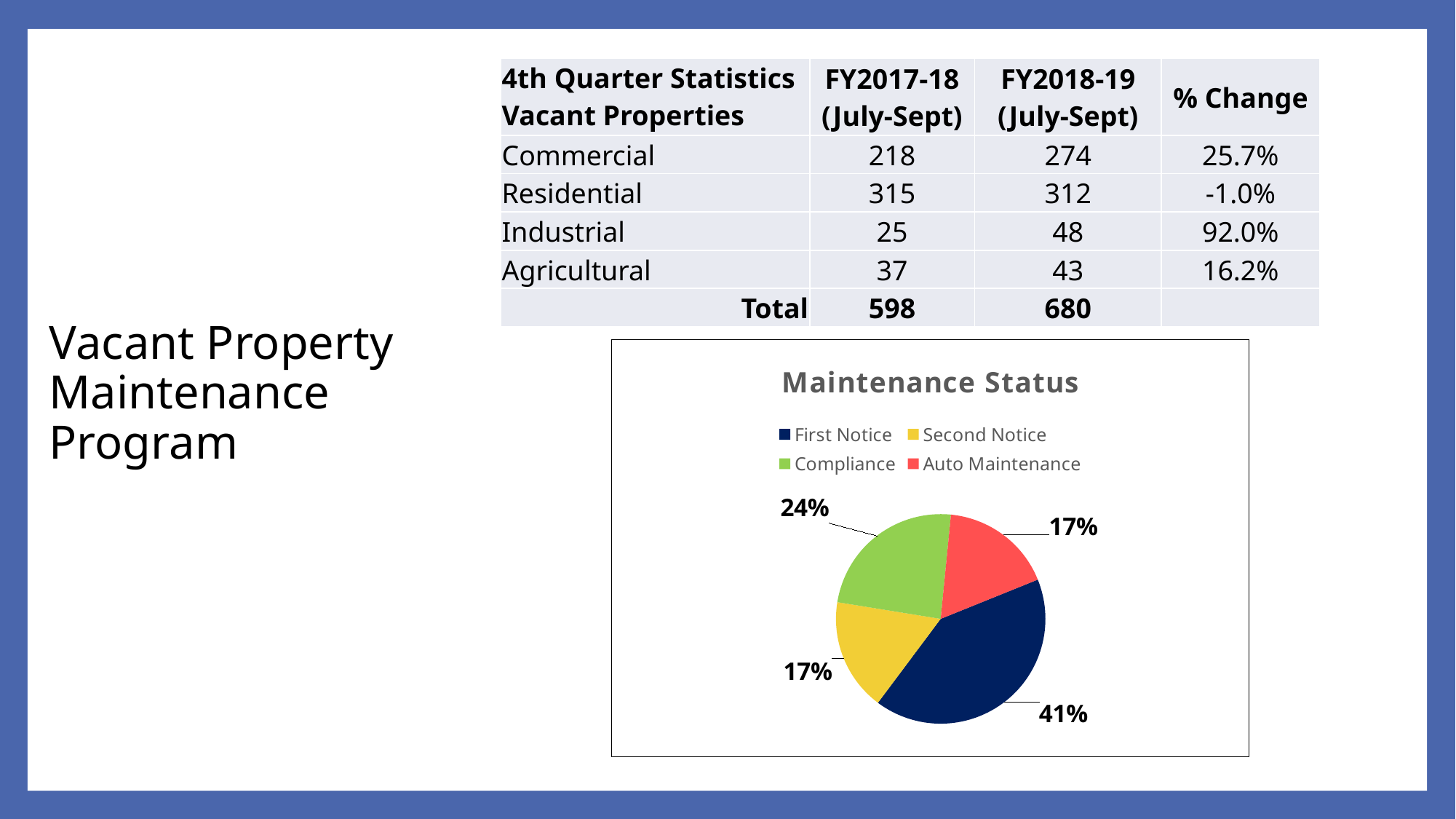
What is the title of the pie chart on the slide? Maintenance Status How many entries does the legend of the Maintenance Status chart list? 4 In the Maintenance Status pie chart, what share is Auto Maintenance? 17% What kind of chart is the Maintenance Status chart? pie chart In the Maintenance Status pie chart, how many percentage points larger is First Notice than Compliance? 17 percentage points In the Maintenance Status pie chart, what share is First Notice? 41% How many slices does the Maintenance Status pie chart have? 4 In the Maintenance Status pie chart, which is larger, Compliance or Second Notice? Compliance In the Maintenance Status pie chart, what share is Second Notice? 17% In the Maintenance Status pie chart, what colour is the First Notice slice? dark blue In the Maintenance Status pie chart, which category has the largest slice? First Notice In the Maintenance Status pie chart, what share is Compliance? 24%